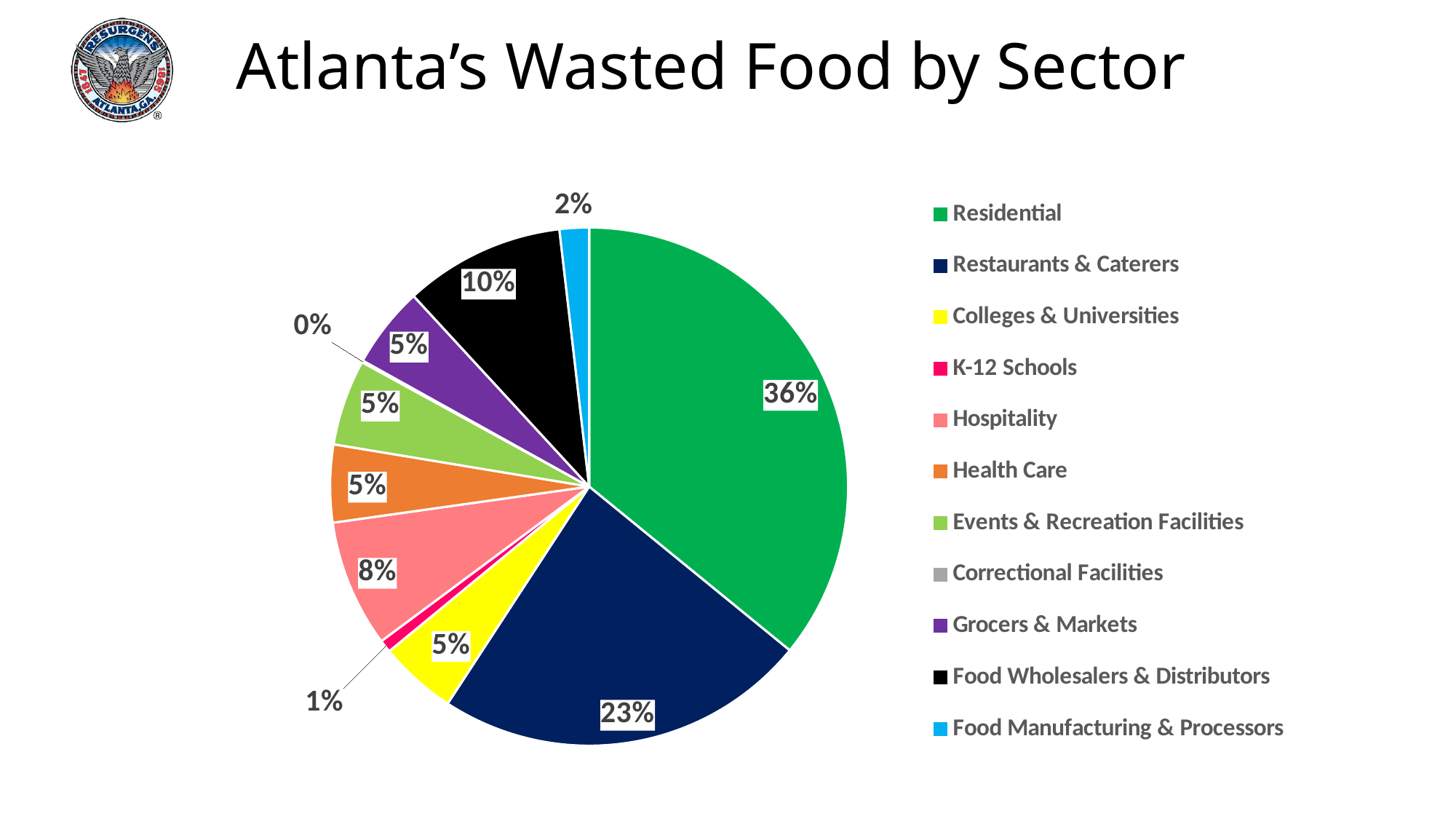
What percentage of wasted food is attributed to Restaurants & Caterers? 23% How many sectors are listed in the legend? 11 What share of wasted food comes from Food Wholesalers & Distributors? 10% What share is shown for Food Manufacturing & Processors? 2% Which sector accounts for the largest share of Atlanta's wasted food? Residential What type of chart is shown on the slide? Pie chart Which sector has a larger share, Hospitality or Food Wholesalers & Distributors? Food Wholesalers & Distributors What percentage is shown for Hospitality? 8% What is the title of the chart? Atlanta's Wasted Food by Sector Which sector has the smallest share, shown as 0%? Correctional Facilities What share of Atlanta's wasted food comes from the Residential sector? 36% How many percentage points larger is the Residential share than the Restaurants & Caterers share? 13